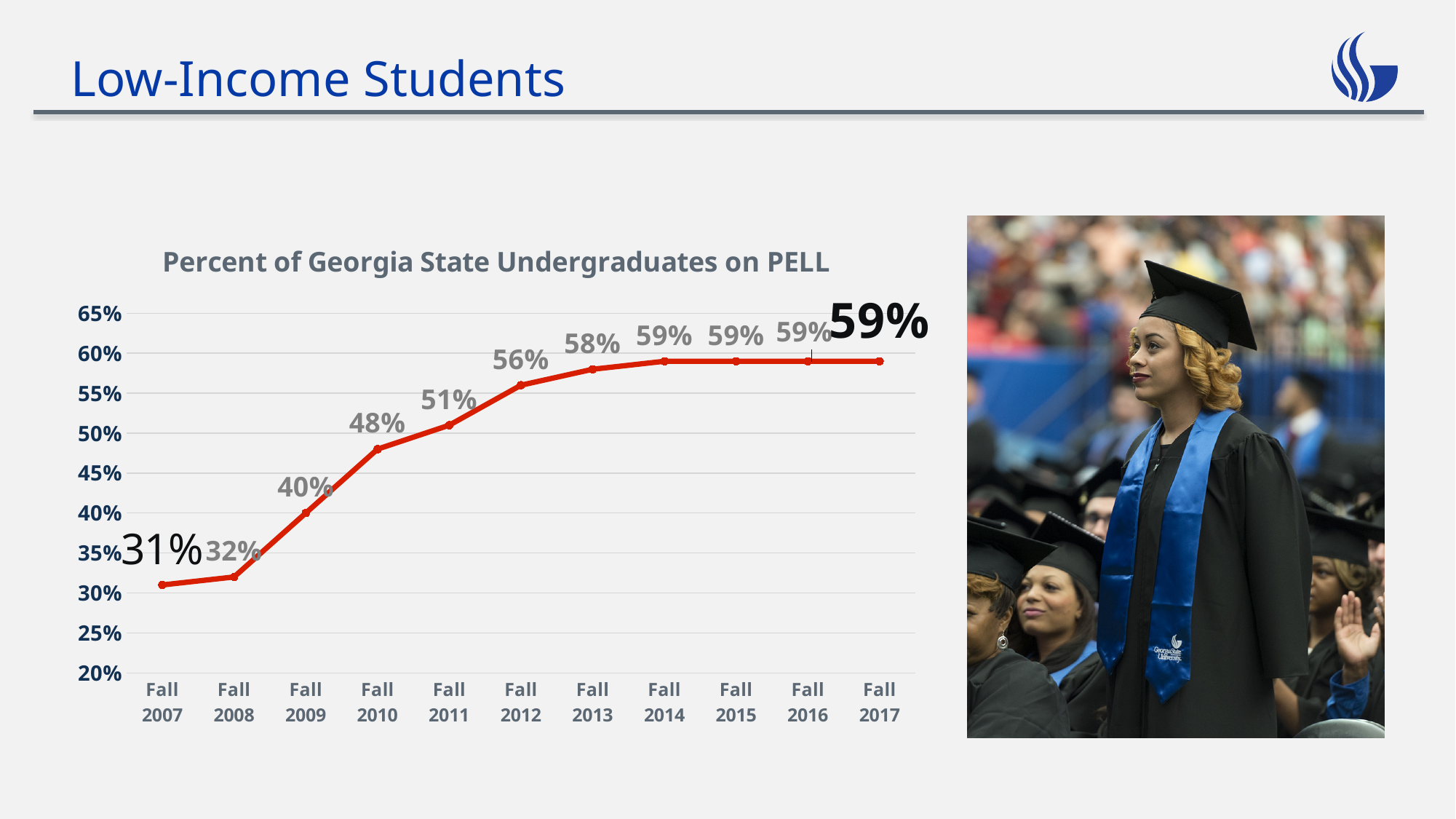
How many data points are plotted on the chart? 11 What is the value for Fall 2010? 48% What is the difference between the values for Fall 2010 and Fall 2009? 8% What is the value for Fall 2007? 31% Which is larger, the value for Fall 2011 or the value for Fall 2013? Fall 2013 Is the value for Fall 2009 greater or less than 45%? less What is the value for Fall 2012? 56% What is the value for Fall 2017? 59% Do the values rise or fall from Fall 2007 to Fall 2014? rise What is the difference between the values for Fall 2017 and Fall 2007? 28% What kind of chart is shown on the slide? line chart Which year has the lowest percent of undergraduates on PELL? Fall 2007